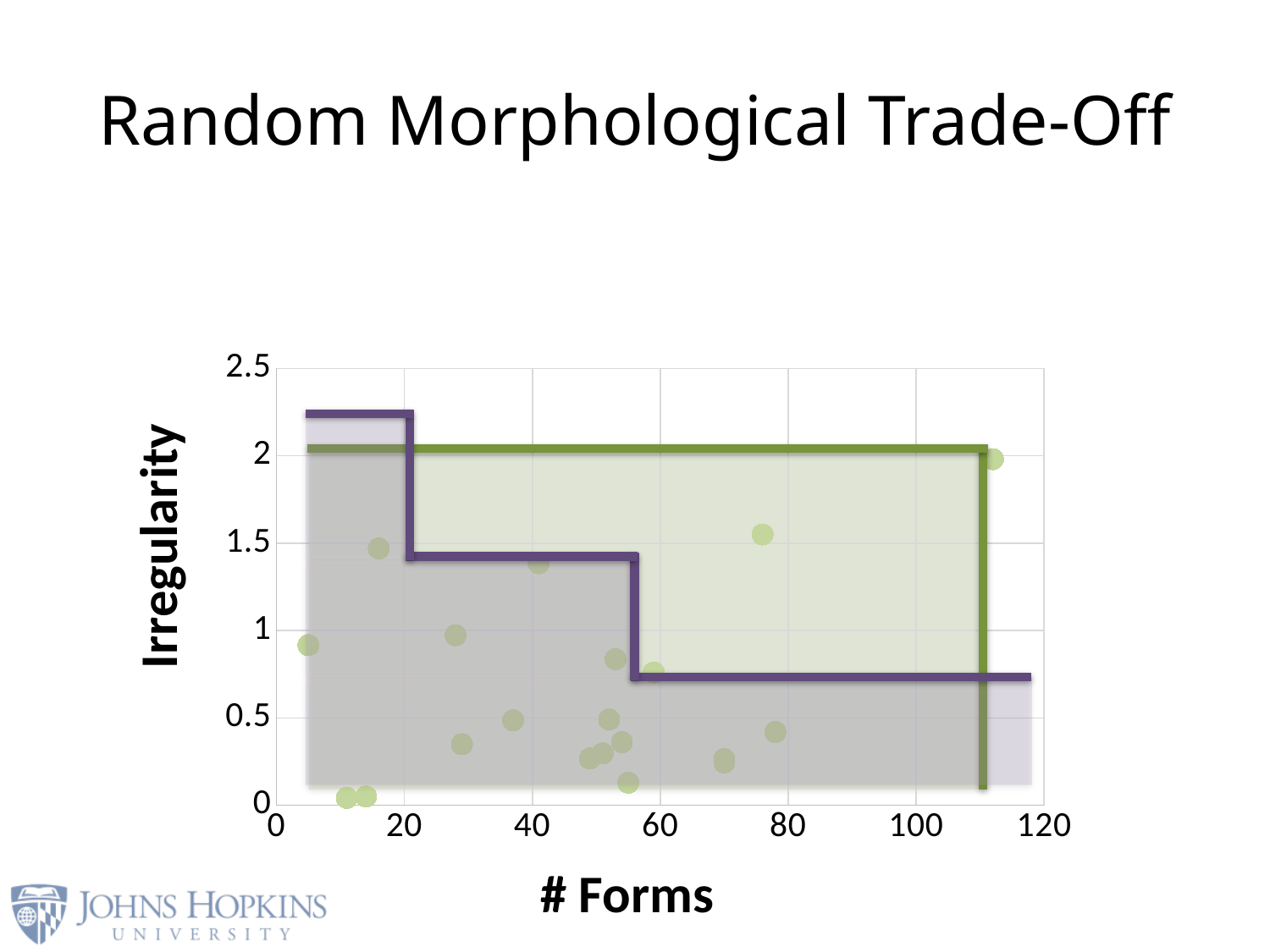
Is the irregularity of the leftmost data point (at about 5 forms) greater or less than 1.5? less What is the title of the chart on the slide? Random Morphological Trade-Off Is the irregularity of the data point at about 76 forms greater or less than 1? greater Which data point has the higher irregularity: the one at about 112 forms or the one at about 76 forms? the one at about 112 forms Is the irregularity of the data point at about 70 forms greater or less than 0.5? less What is the label of the x axis? # Forms What kind of chart is shown on the slide? scatter chart